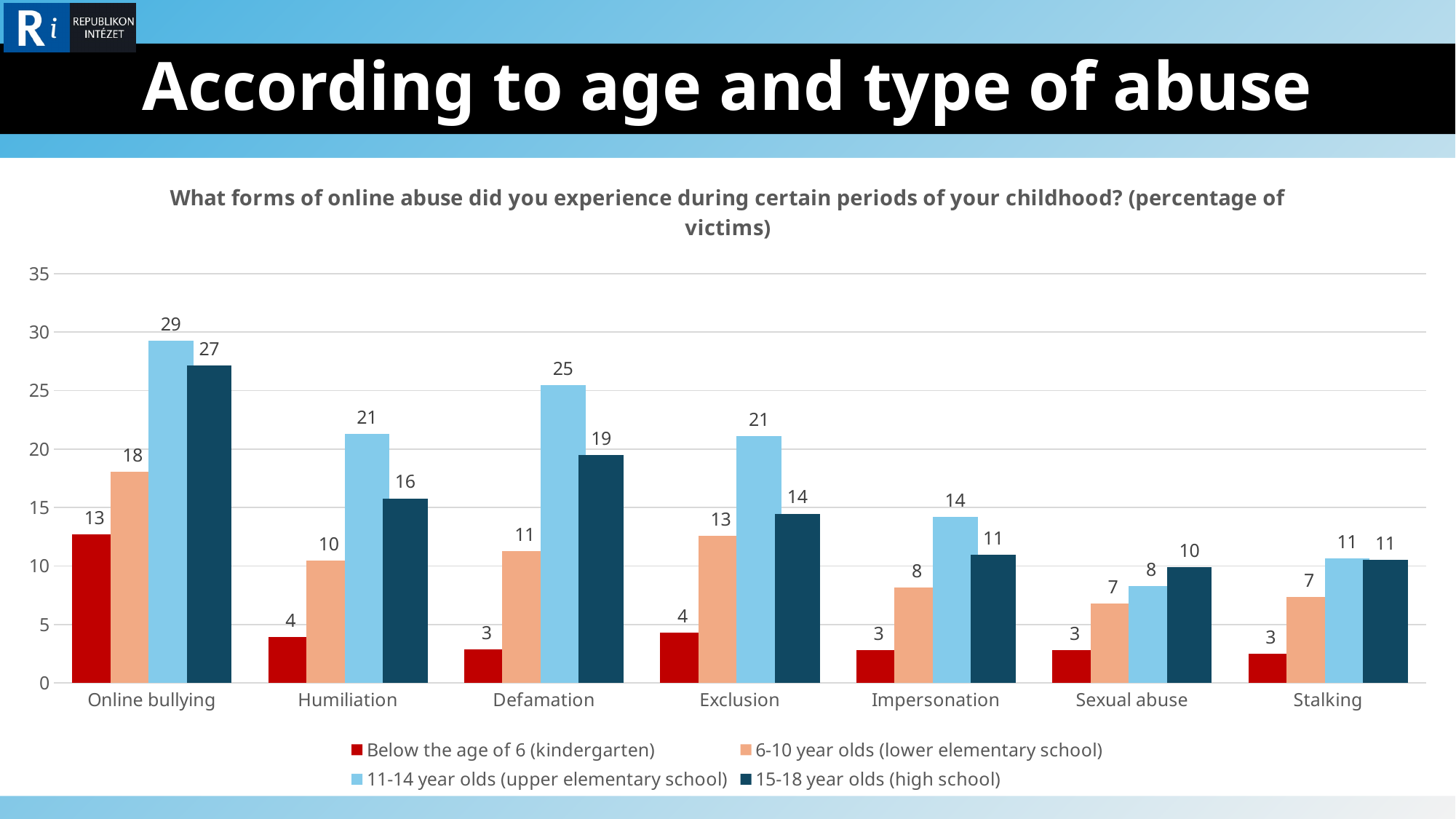
Which category has the highest value for 11-14 year olds (upper elementary school)? Online bullying What is the value for 11-14 year olds (upper elementary school) for Online bullying? 29 What is the value for 6-10 year olds (lower elementary school) for Stalking? 7 What is the difference between the 11-14 year olds and 15-18 year olds values for Defamation? 6 What is the value for Below the age of 6 (kindergarten) for Defamation? 3 How many abuse categories are shown on the x axis? 7 Which series is shown in red? Below the age of 6 (kindergarten) What is the value for 15-18 year olds (high school) for Exclusion? 14 Which category has the lowest value for 6-10 year olds (lower elementary school)? Sexual abuse and Stalking (both 7) Which is larger for Humiliation: the value for 6-10 year olds or the value for 15-18 year olds? 15-18 year olds (high school) What kind of chart is shown on the slide? Bar chart How many series does the legend list? 4